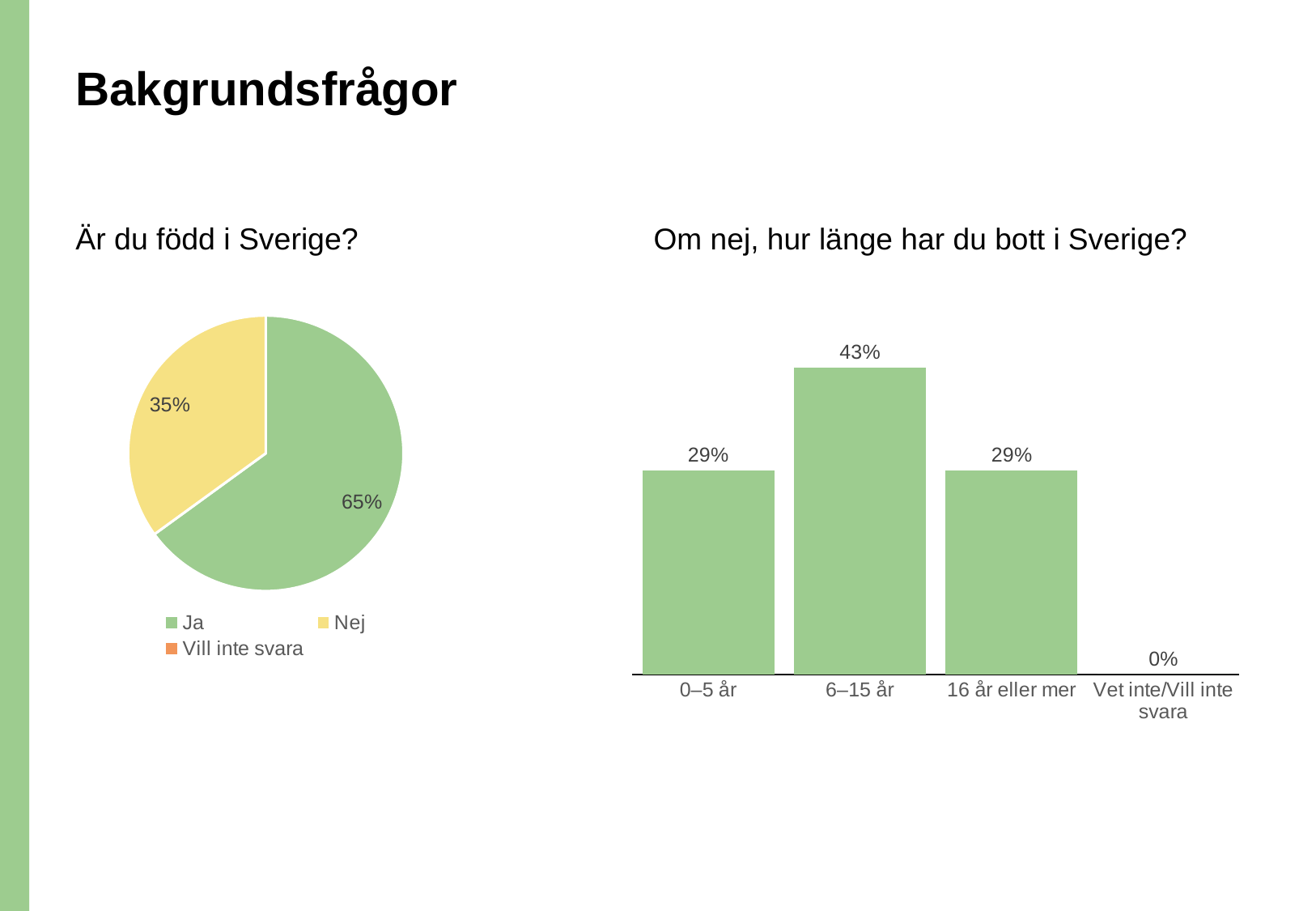
In the bar chart 'Om nej, hur länge har du bott i Sverige?', which category has the highest value? 6–15 år In the bar chart 'Om nej, hur länge har du bott i Sverige?', what is the value for Vet inte/Vill inte svara? 0% In the bar chart 'Om nej, hur länge har du bott i Sverige?', what is the value for 0–5 år? 29% In the pie chart 'Är du född i Sverige?', what share is labelled for Nej? 35% What kind of chart is the chart on the left of the slide? Pie chart In the bar chart 'Om nej, hur länge har du bott i Sverige?', what is the value for 6–15 år? 43% What kind of chart is the chart on the right of the slide? Bar chart In the bar chart 'Om nej, hur länge har du bott i Sverige?', how many categories are shown on the x axis? 4 In the pie chart 'Är du född i Sverige?', what share is labelled for Ja? 65% In the bar chart 'Om nej, hur länge har du bott i Sverige?', what is the difference between the values for 6–15 år and 16 år eller mer? 14% In the pie chart 'Är du född i Sverige?', how many entries does the legend list? 3 In the pie chart 'Är du född i Sverige?', which slice is the largest? Ja